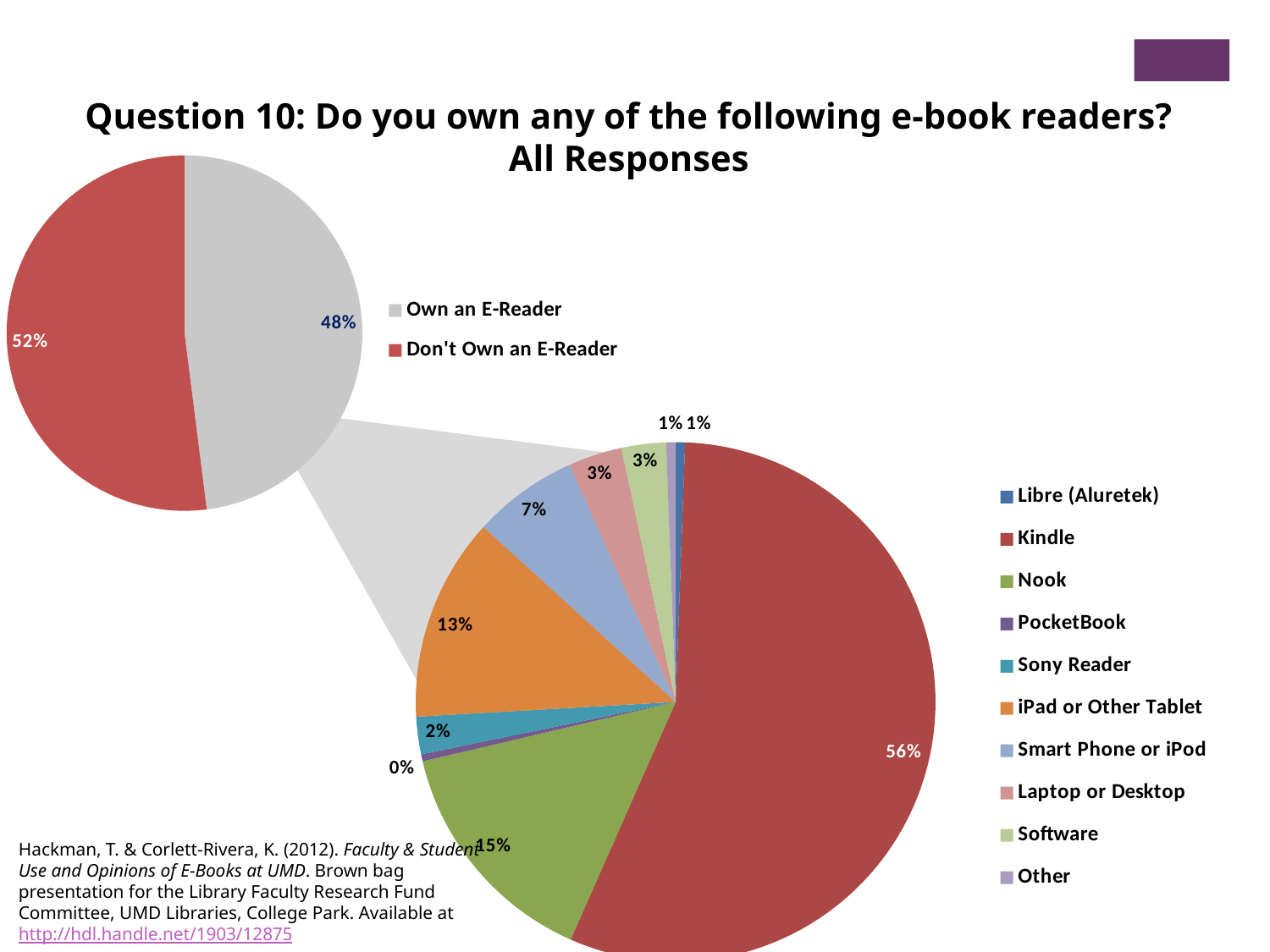
In the large pie chart, what share of responses is iPad or Other Tablet? 13% In the small pie chart at the upper left, what percentage of respondents own an e-reader? 48% In the small pie chart at the upper left, which slice is larger: Own an E-Reader or Don't Own an E-Reader? Don't Own an E-Reader In the small pie chart at the upper left, how many slices are there? 2 In the small pie chart at the upper left, what percentage of respondents don't own an e-reader? 52% In the large pie chart, which device has the largest share? Kindle What type of charts are shown on the slide? Pie charts In the large pie chart, what is the difference in percentage points between Kindle and Nook? 41 In the large pie chart, what share of responses is Smart Phone or iPod? 7% In the large pie chart, what share of responses is Kindle? 56% How many entries does the legend of the large pie chart list? 10 In the large pie chart, what share of responses is Nook? 15%